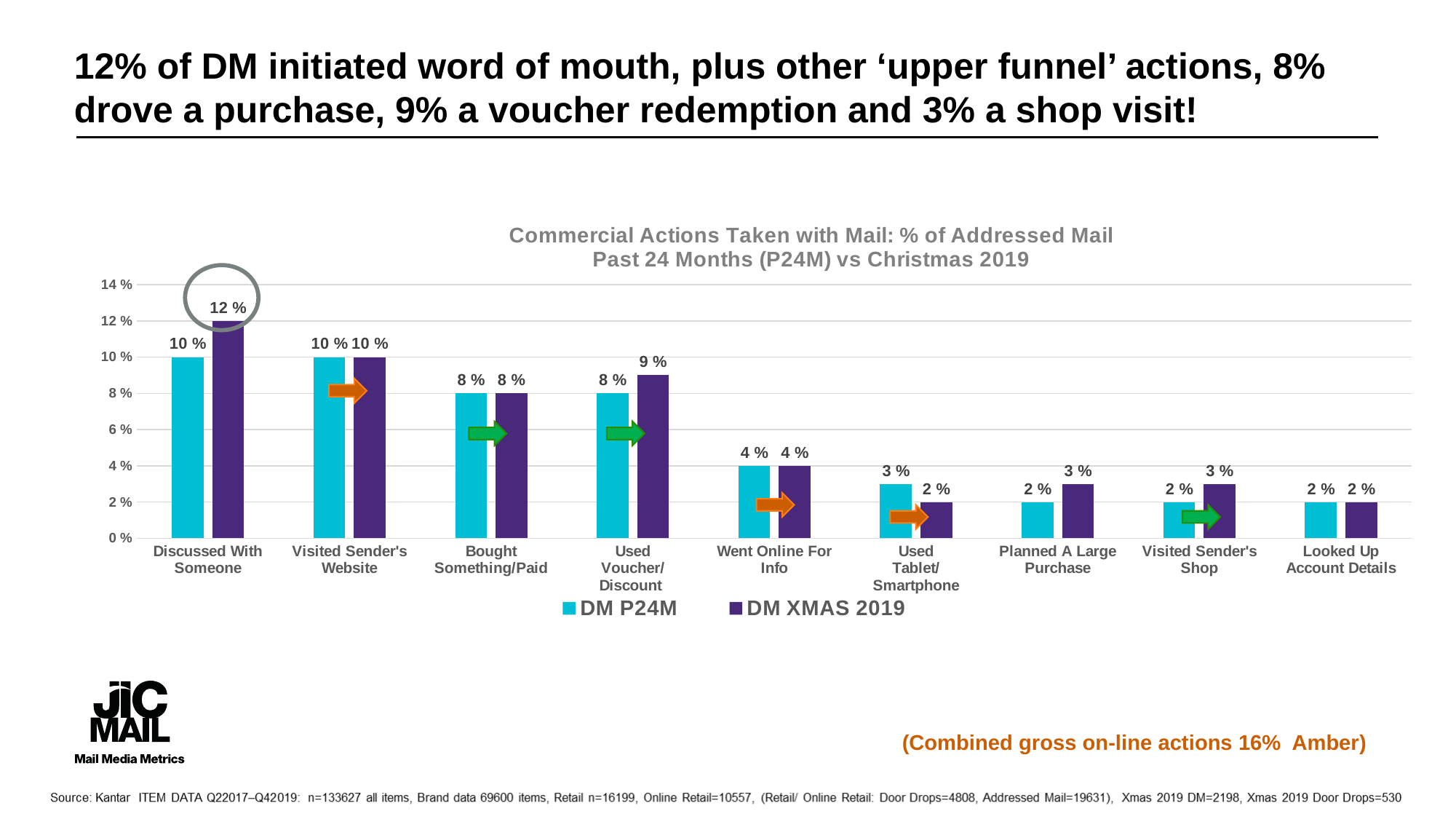
For Used Tablet/Smartphone, which series has the larger value, DM P24M or DM XMAS 2019? DM P24M Which category has the highest DM XMAS 2019 value? Discussed With Someone What is the DM P24M value for Used Voucher/Discount? 8 % For Planned A Large Purchase, which series has the larger value, DM P24M or DM XMAS 2019? DM XMAS 2019 What kind of chart is shown? Bar chart How many series does the legend list? 2 How many categories are shown on the x axis? 9 What is the DM XMAS 2019 value for Discussed With Someone? 12 % Which series is shown in purple in the legend? DM XMAS 2019 What is the DM XMAS 2019 value for Used Tablet/Smartphone? 2 % What is the DM P24M value for Went Online For Info? 4 % What is the difference between the DM XMAS 2019 and DM P24M values for Discussed With Someone? 2 %